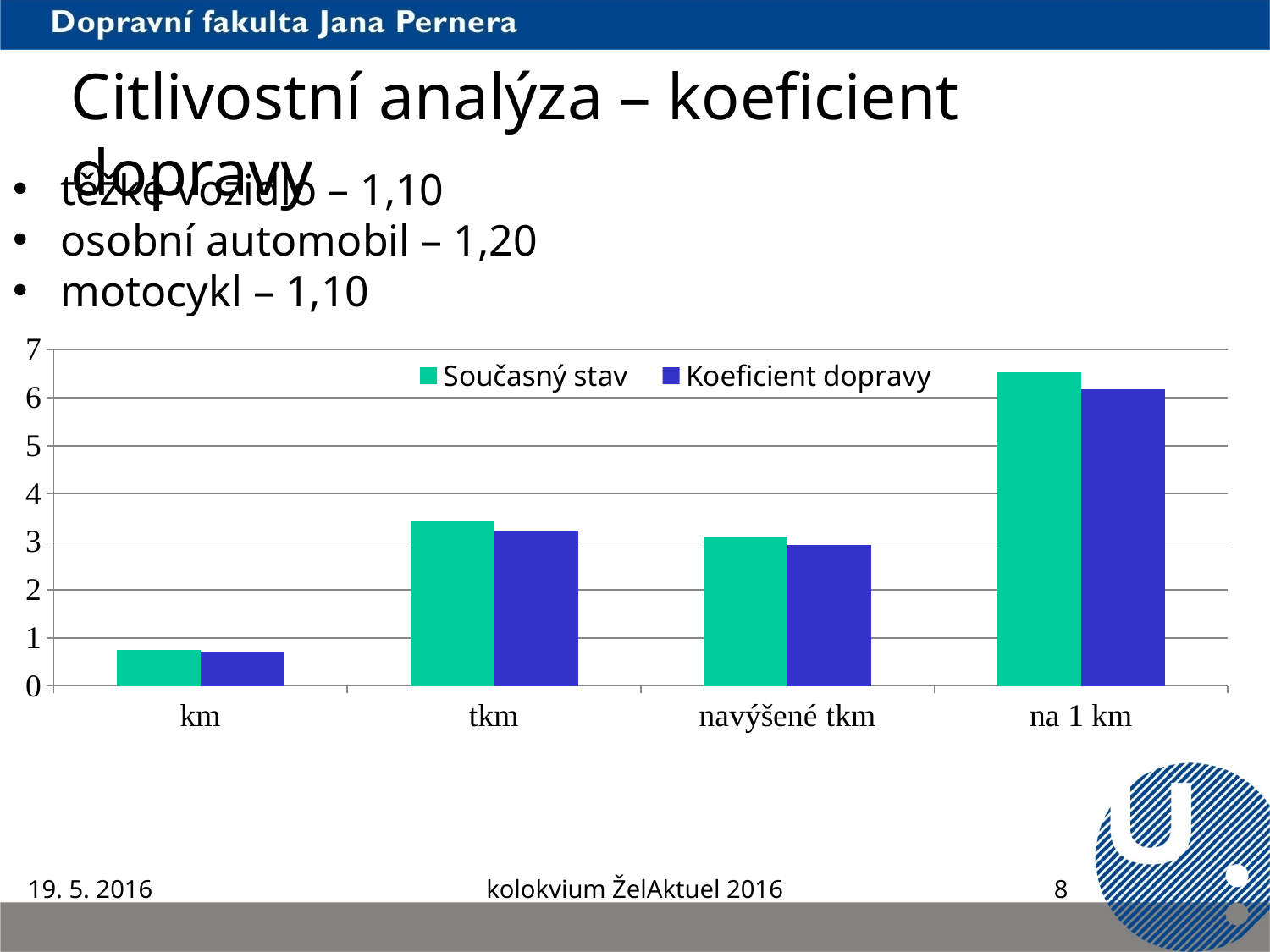
How many series does the chart legend list? 2 Which series is shown in green in the chart? Současný stav Which category has the lowest value for Koeficient dopravy? km Is the Koeficient dopravy value for km greater or less than 1? less For Současný stav, which category has the larger value, tkm or navýšené tkm? tkm How many categories are shown on the x axis of the chart? 4 Is the Koeficient dopravy value for na 1 km greater or less than 5? greater Is the Současný stav value for tkm greater or less than 3? greater What kind of chart is shown on the slide? bar chart Which category has the highest value for Současný stav? na 1 km For na 1 km, which series has the larger value, Současný stav or Koeficient dopravy? Současný stav